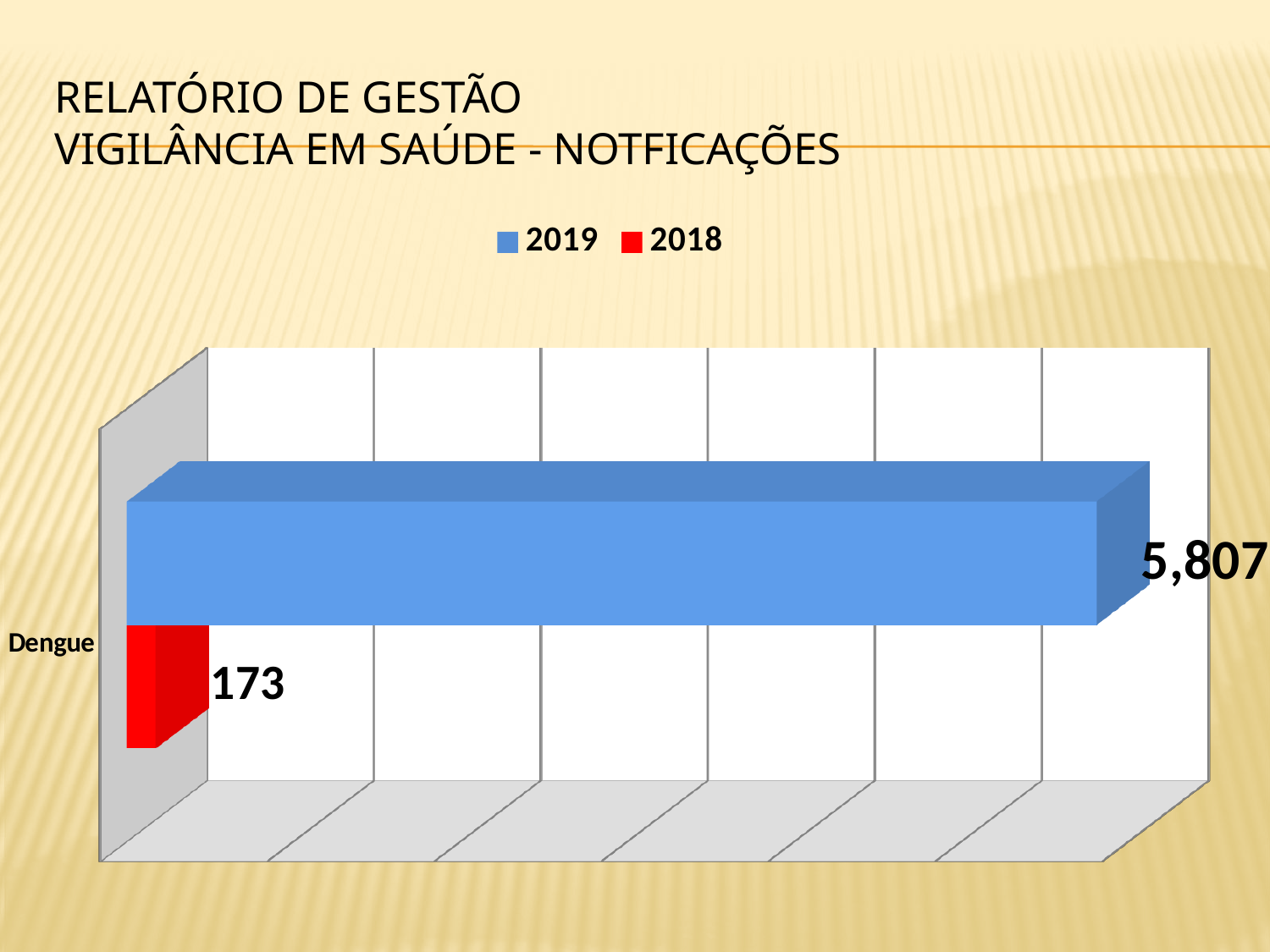
What is the name of the category shown on the chart? Dengue What kind of chart is shown on the slide? Bar chart How many categories are shown on the chart? 1 What is the value for 2019 for Dengue? 5,807 What colour represents the 2019 series in the legend? Blue Which series is the smaller of the two for Dengue? 2018 Which series has the larger value for Dengue, 2019 or 2018? 2019 How many series does the legend list? 2 What is the difference between the 2019 and 2018 values for Dengue? 5,634 What is the value for 2018 for Dengue? 173